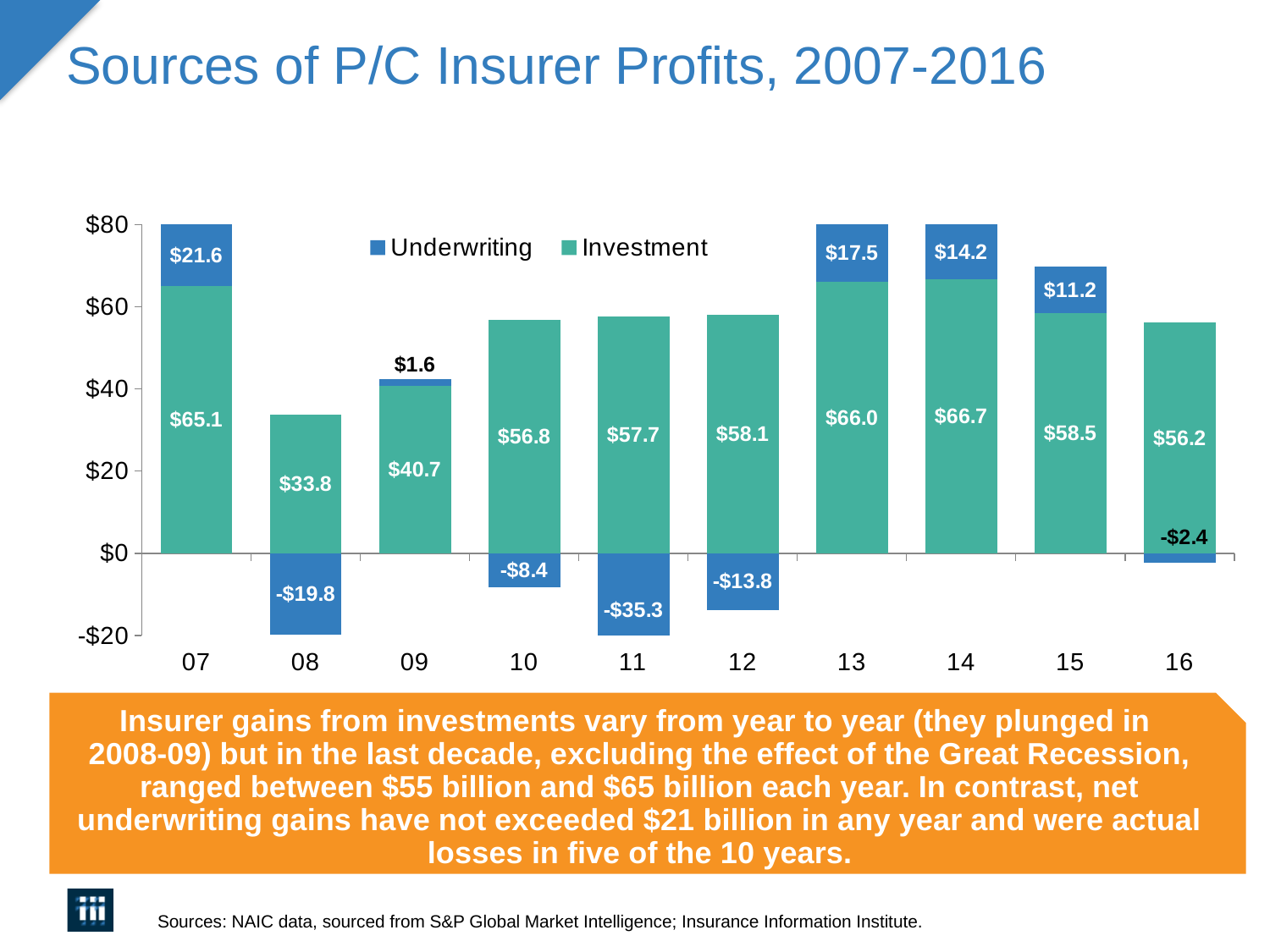
Which year has the highest Investment value? 14 What kind of chart is shown on the slide? Stacked bar chart What is the difference between the Investment values for 2007 and 2008? $31.3 What is the Underwriting value for 2009? $1.6 What is the Underwriting value for 2011? -$35.3 What is the total of the Underwriting and Investment values for 2007? $86.7 How many years are shown on the x axis? 10 How many series does the legend list? 2 Which year has the highest Underwriting value? 07 Which year has the larger Underwriting value, 2013 or 2014? 13 Which year has the lowest Investment value? 08 What is the Investment value for 2014? $66.7